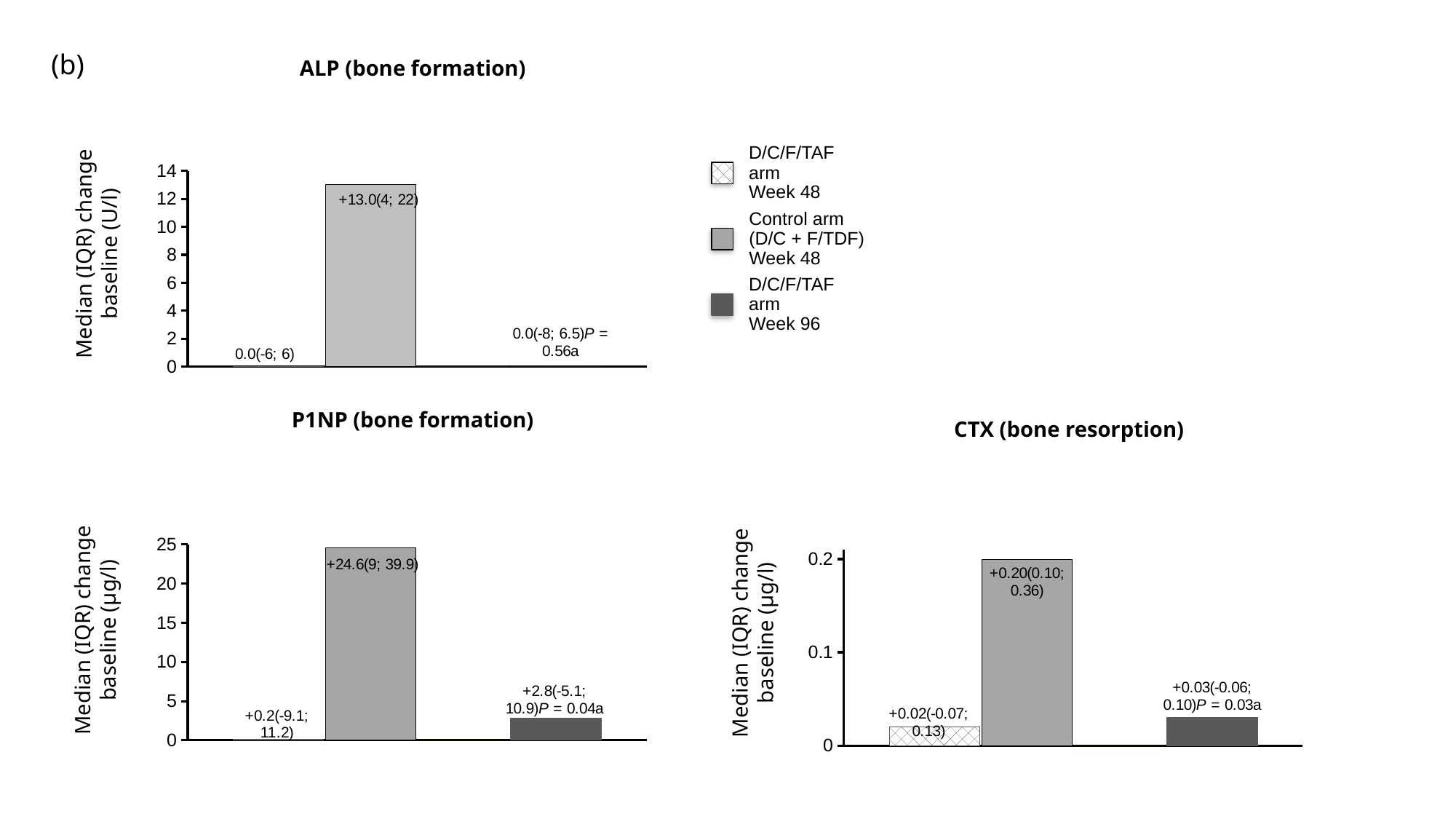
In the P1NP (bone formation) chart, what is the median change from baseline for the D/C/F/TAF arm at Week 48? +0.2 What kind of chart is the CTX (bone resorption) chart? bar chart How many series does the legend list? 3 How many charts are shown on the slide? 3 In the CTX (bone resorption) chart, which arm has the highest median change from baseline? Control arm (D/C + F/TDF) Week 48 In the CTX (bone resorption) chart, which is larger: the median change for the D/C/F/TAF arm at Week 48 or at Week 96? D/C/F/TAF arm Week 96 In the P1NP (bone formation) chart, what is the median change from baseline for the Control arm (D/C + F/TDF) at Week 48? +24.6 What is the y-axis label of the ALP (bone formation) chart? Median (IQR) change baseline (U/l) In the P1NP (bone formation) chart, what is the difference between the median change for the Control arm at Week 48 and the D/C/F/TAF arm at Week 96? 21.8 In the CTX (bone resorption) chart, what is the median change from baseline for the D/C/F/TAF arm at Week 96? +0.03 In the ALP (bone formation) chart, is the value for the Control arm (D/C + F/TDF) at Week 48 greater or less than 12? greater In the ALP (bone formation) chart, what is the median change from baseline for the Control arm (D/C + F/TDF) at Week 48? +13.0